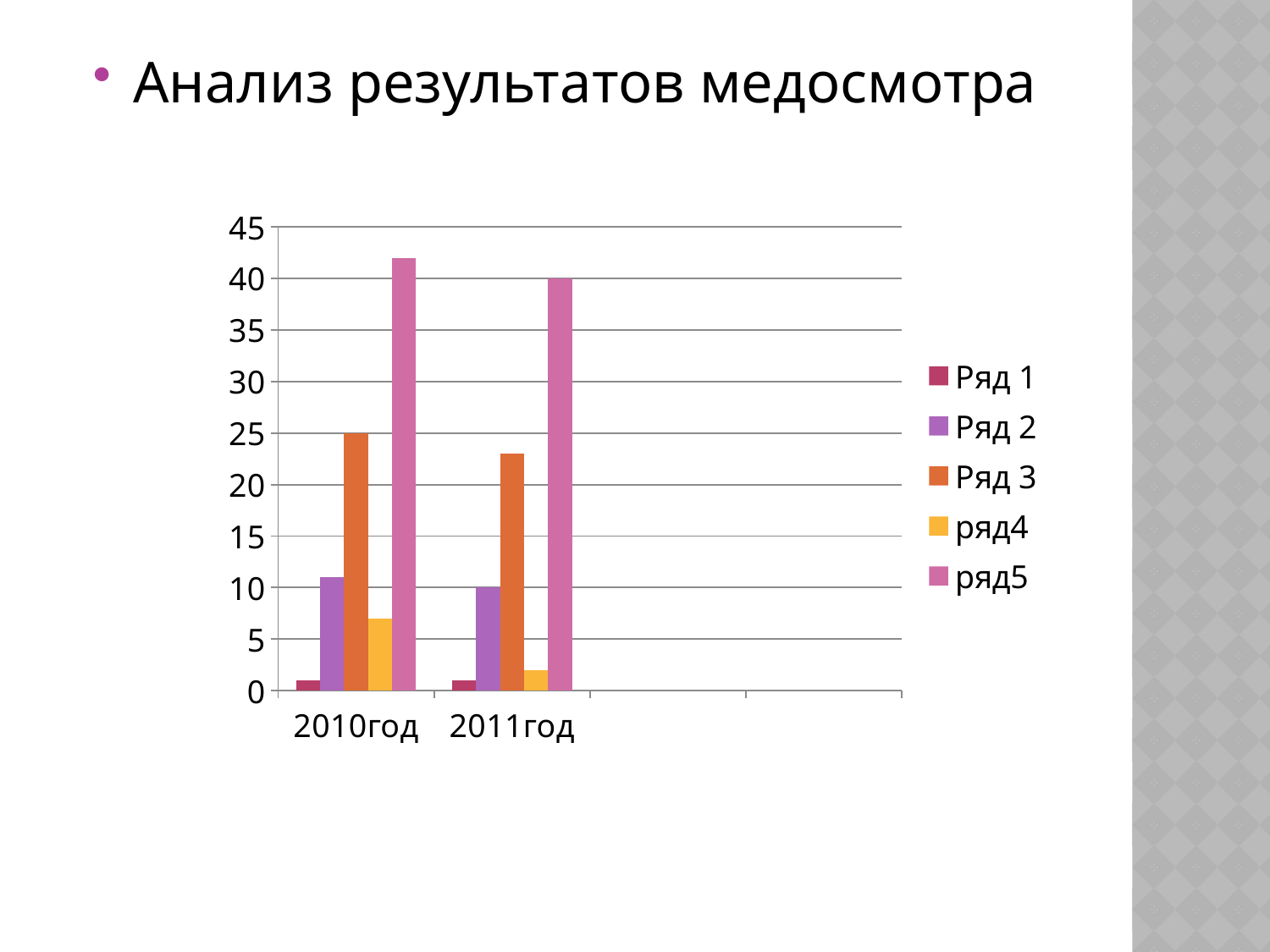
Is the value for Ряд 3 in 2011год greater or less than 25? less What is the title of the slide containing the chart? Анализ результатов медосмотра Is the value for ряд5 in 2010год greater or less than 40? greater Does the value for ряд5 rise or fall from 2010год to 2011год? fall What kind of chart is shown on the slide? bar chart Which series has the lowest value for 2010год? Ряд 1 For Ряд 3, which year has the larger value, 2010год or 2011год? 2010год Which series has the highest value for 2010год? ряд5 For ряд4, which year has the larger value, 2010год or 2011год? 2010год How many series does the chart's legend list? 5 How many categories are shown on the x axis of the chart? 2 Is the value for ряд4 in 2010год greater or less than 5? greater